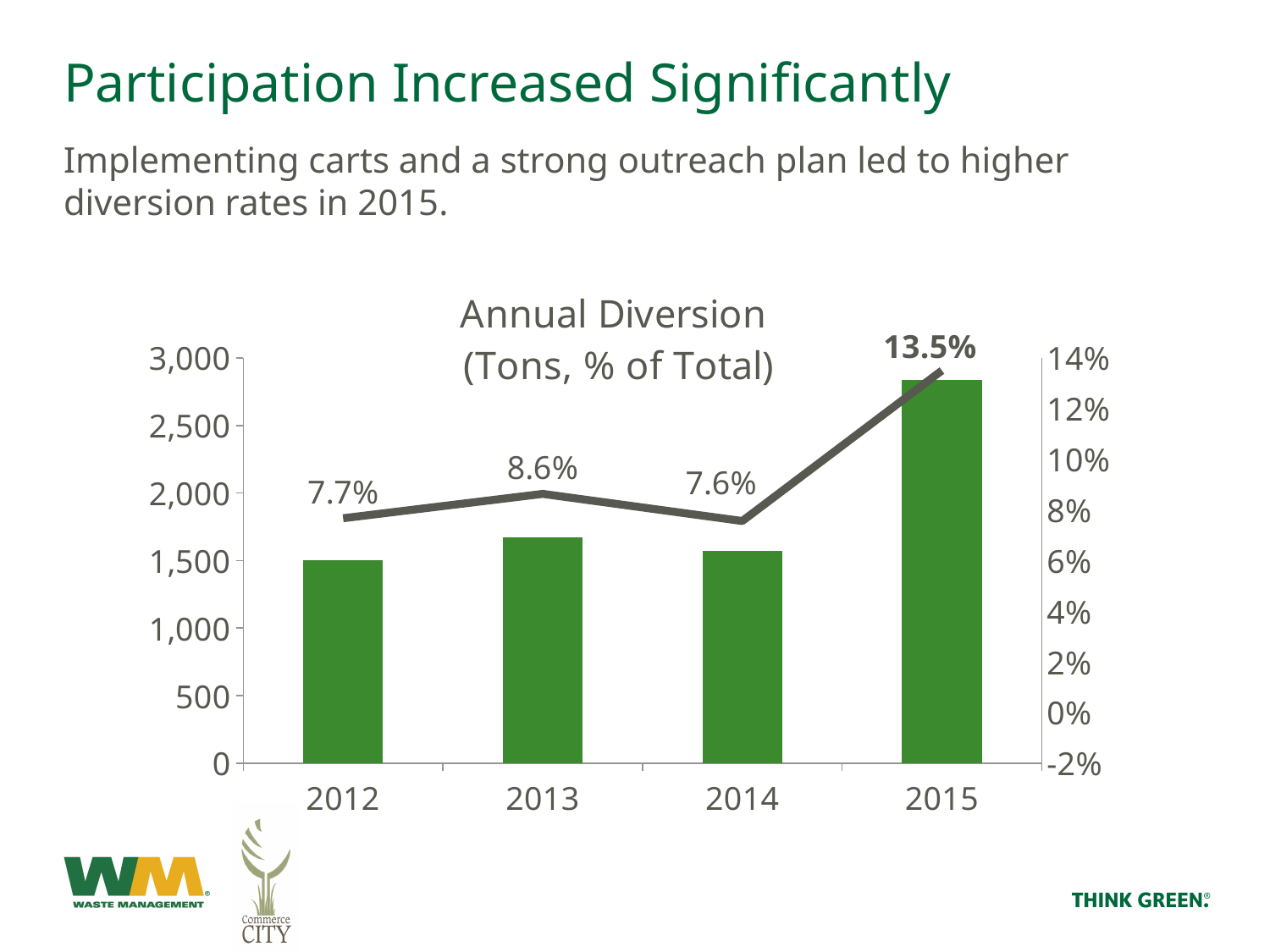
What is the diversion rate (% of total) shown for 2013? 8.6% What is the diversion rate (% of total) shown for 2012? 7.7% What is the diversion rate (% of total) shown for 2015? 13.5% What is the title of the chart? Annual Diversion (Tons, % of Total) By how many percentage points did the diversion rate increase from 2014 to 2015? 5.9 percentage points Which year has the highest diversion rate (% of total)? 2015 Is the tons value for 2015 greater or less than 2,500? greater Which year had a higher diversion rate, 2013 or 2014? 2013 Which year has the lowest diversion rate (% of total)? 2014 How many years are shown on the x axis of the chart? 4 Is the tons value for 2012 greater or less than 2,000? less What kind of chart is shown on the slide? A bar chart with a line overlay